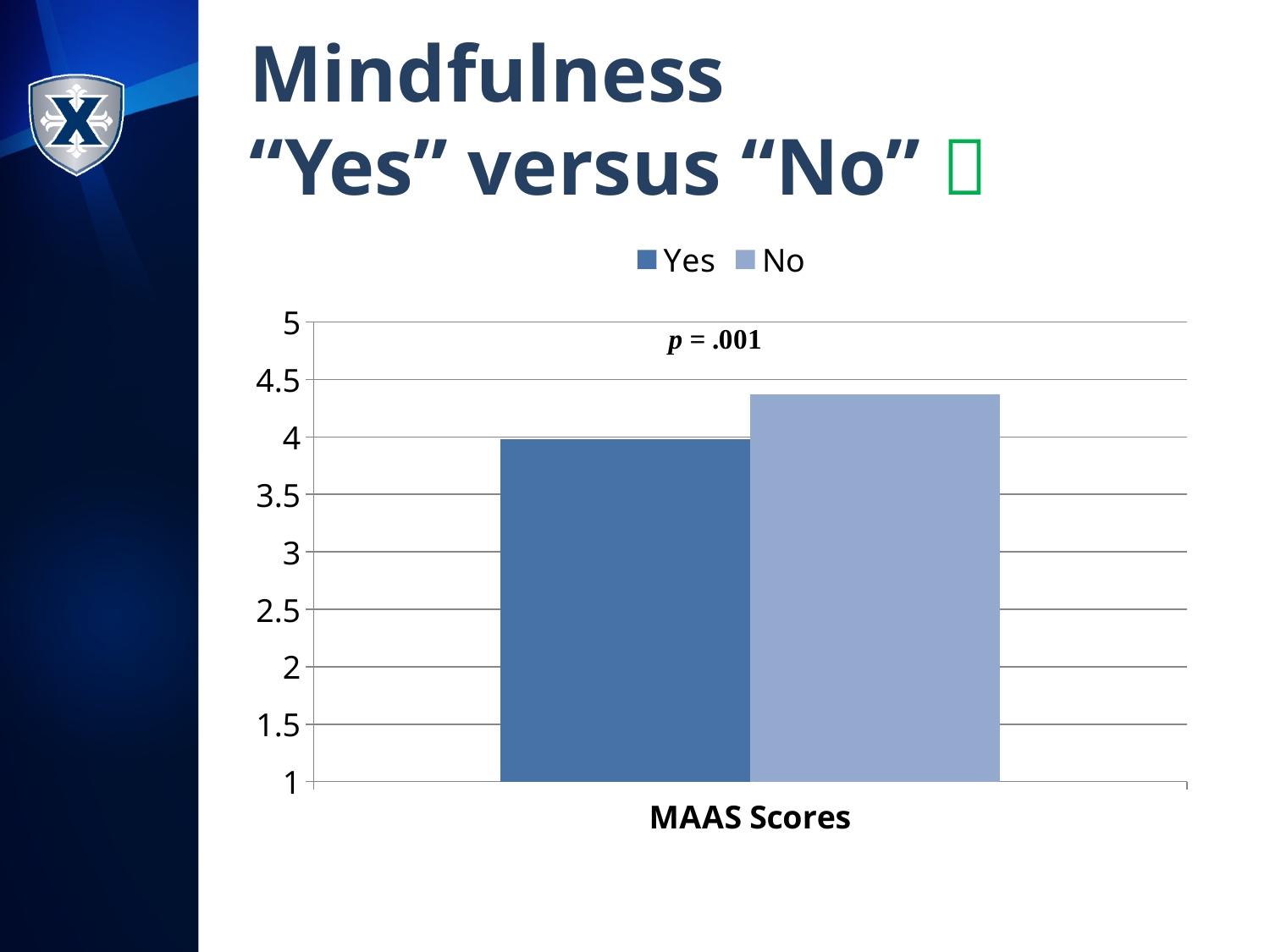
What kind of chart is shown on the slide? bar chart Is the value for the No series greater or less than 4? greater What is the label on the x axis? MAAS Scores What p-value is printed on the chart? p = .001 How many series does the legend list? 2 Which series has the tallest bar? No How many categories are shown on the x axis? 1 What are the two series named in the legend? Yes and No Which series has the higher MAAS Scores bar, Yes or No? No Is the value for the No series greater or less than 4.5? less Is the value for the Yes series greater or less than 3.5? greater Which series has the shortest bar? Yes